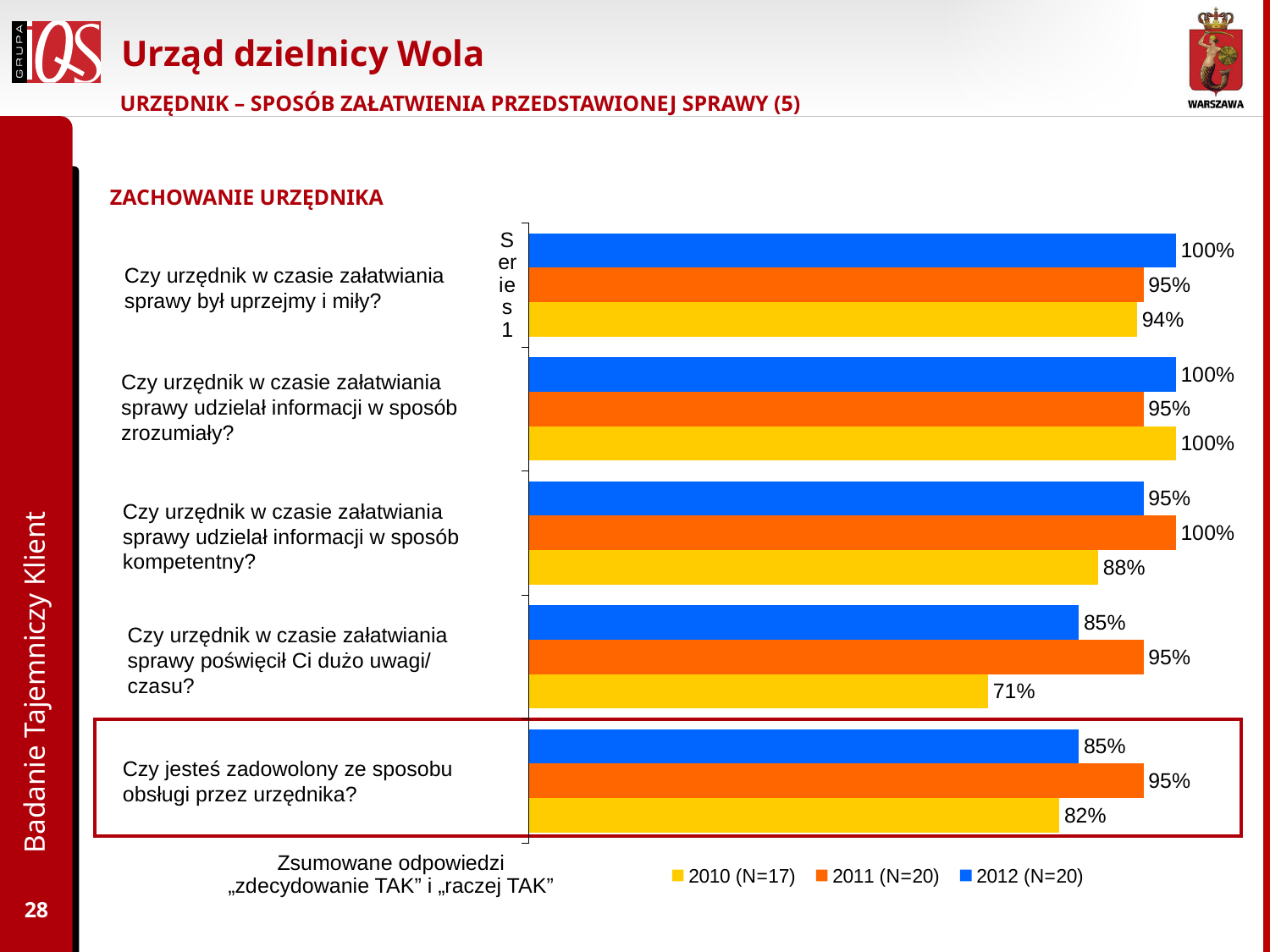
What is the difference between the 2012 (N=20) and 2010 (N=17) values for "Czy urzędnik w czasie załatwiania sprawy udzielał informacji w sposób kompetentny?"? 7% What is the 2011 (N=20) value for "Czy urzędnik w czasie załatwiania sprawy udzielał informacji w sposób kompetentny?"? 100% What is the 2012 (N=20) value for "Czy jesteś zadowolony ze sposobu obsługi przez urzędnika?"? 85% What is the 2010 (N=17) value for "Czy urzędnik w czasie załatwiania sprawy poświęcił Ci dużo uwagi/ czasu?"? 71% Which colour represents the 2012 (N=20) series in the legend? blue What is the 2010 (N=17) value for "Czy urzędnik w czasie załatwiania sprawy był uprzejmy i miły?"? 94% Which question has the lowest 2010 (N=17) value? Czy urzędnik w czasie załatwiania sprawy poświęcił Ci dużo uwagi/ czasu? How many series does the legend list? 3 What type of chart is shown on the slide? bar chart For "Czy jesteś zadowolony ze sposobu obsługi przez urzędnika?", which is larger: the 2011 (N=20) value or the 2010 (N=17) value? 2011 (N=20) How many question categories are plotted on the chart? 5 What is the difference between the 2011 (N=20) and 2010 (N=17) values for "Czy urzędnik w czasie załatwiania sprawy poświęcił Ci dużo uwagi/ czasu?"? 24%